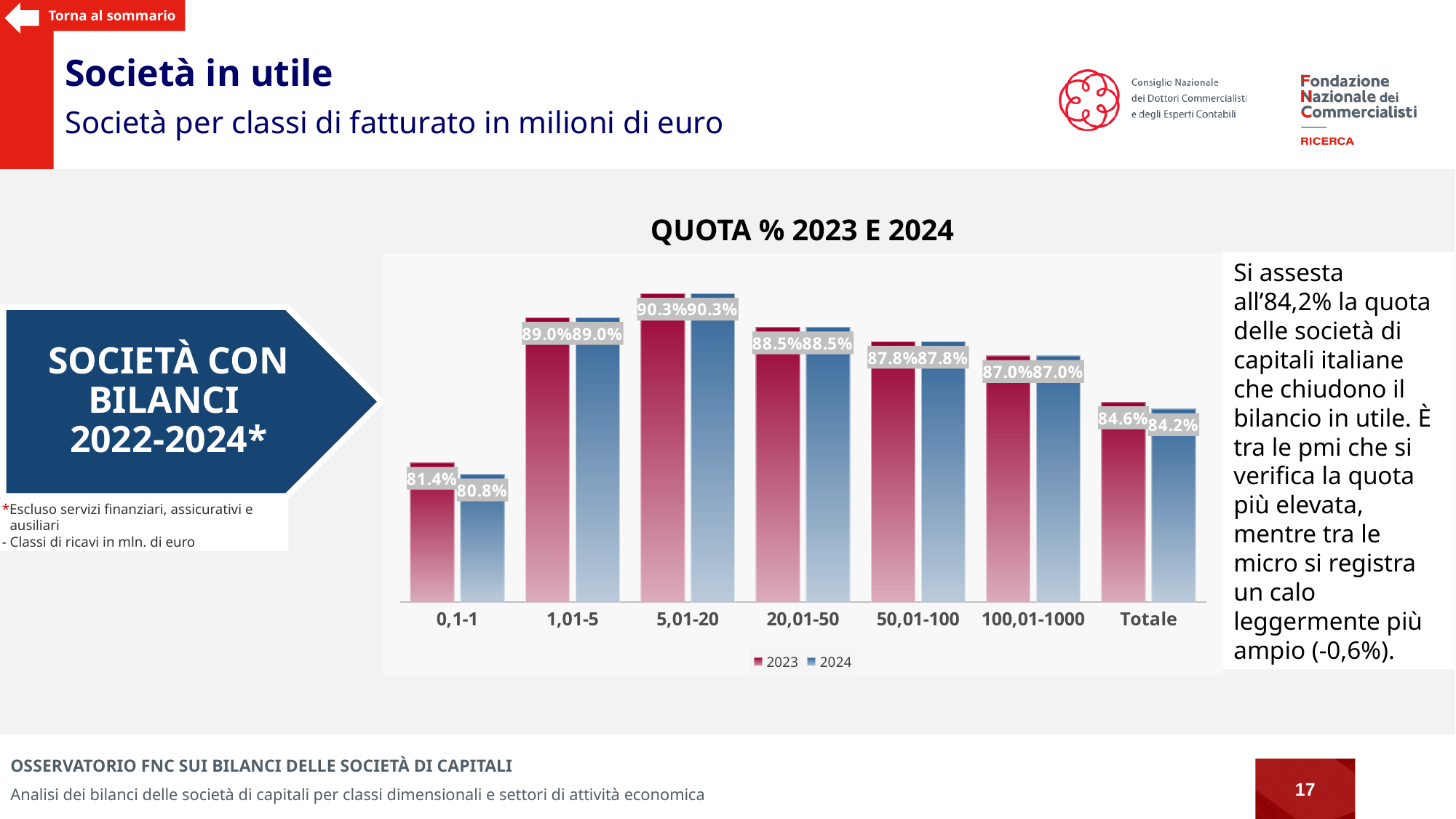
How many revenue classes (categories) are shown on the x axis? 7 What is the difference between the 2023 and 2024 values for Totale? 0.4% What is the 2024 value for Totale? 84.2% What is the 2023 value for the 0,1-1 class? 81.4% What is the 2024 value for the 0,1-1 class? 80.8% How many series does the legend list? 2 What kind of chart is shown? Bar chart What is the 2024 value for the 100,01-1000 class? 87.0% Which revenue class has the highest 2024 value? 5,01-20 What is the 2023 value for the 5,01-20 class? 90.3% Which revenue class has the lowest 2023 value? 0,1-1 Which is larger for the 0,1-1 class, the 2023 value or the 2024 value? 2023